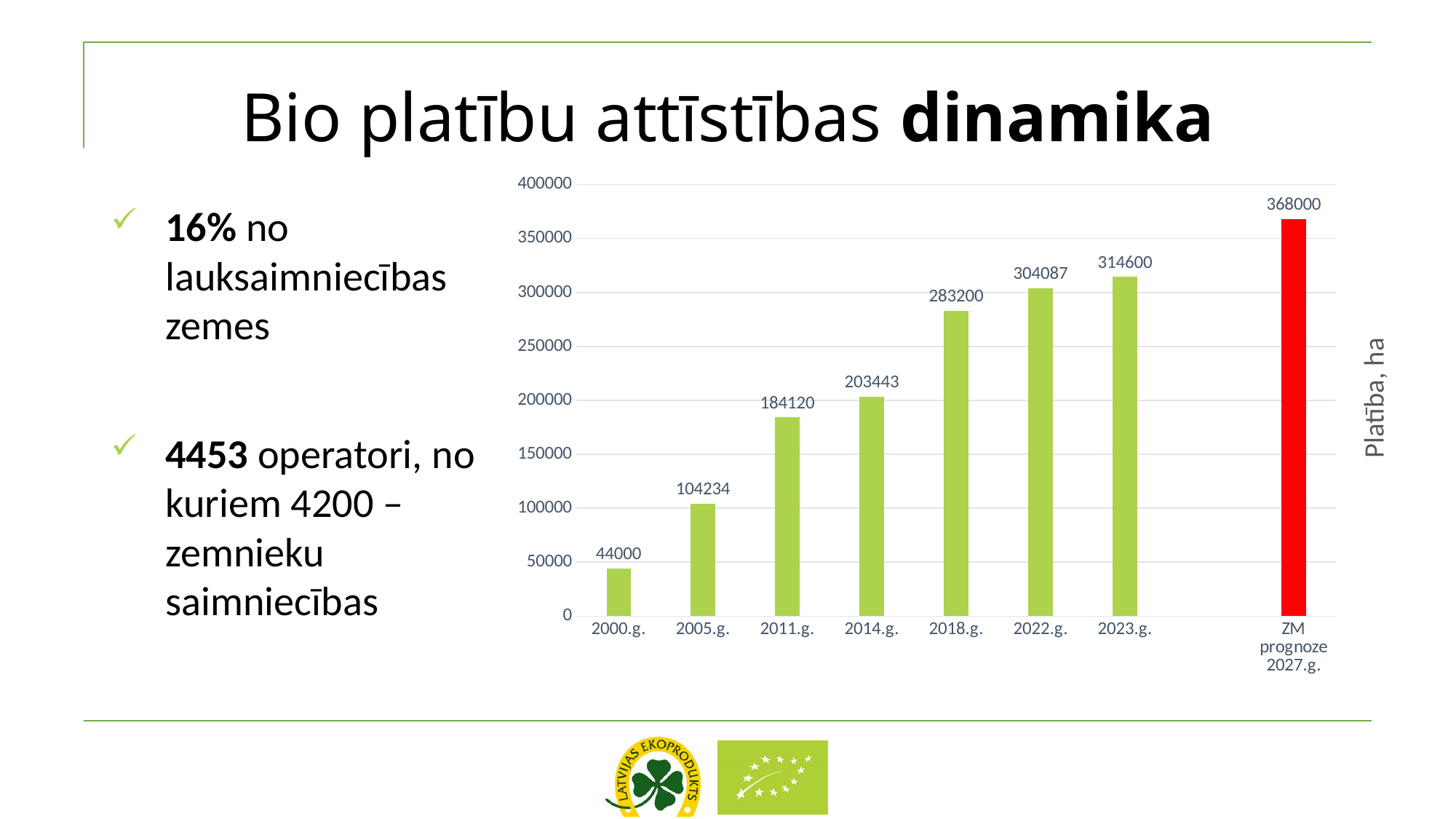
Which category has the highest value? ZM prognoze 2027.g. What is the difference between the values for 2005.g. and 2000.g.? 60234 How many categories are shown on the x axis? 8 What is the difference between the values for 2023.g. and 2022.g.? 10513 What kind of chart is shown on the slide? bar chart What is the value for ZM prognoze 2027.g.? 368000 Which category has the lowest value? 2000.g. Which is larger, the value for 2011.g. or the value for 2014.g.? 2014.g. What is the value for 2000.g.? 44000 What is the value for 2018.g.? 283200 Do the values rise or fall from 2000.g. to 2023.g.? rise What is the value for 2023.g.? 314600